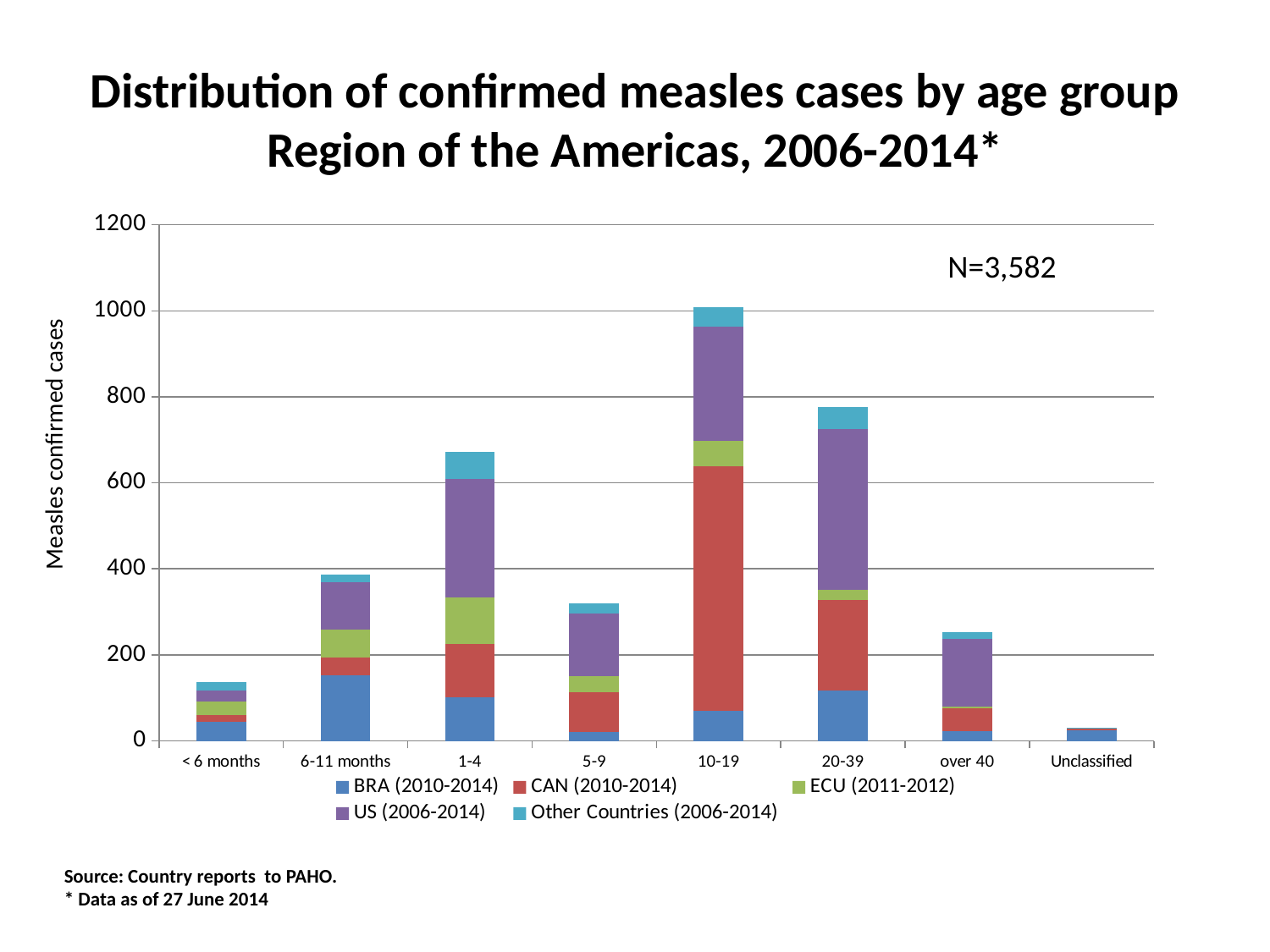
What kind of chart is shown on the slide? stacked bar chart Which series in the legend covers the years 2011-2012? ECU (2011-2012) Which has a larger total of confirmed cases, the 1-4 age group or the 5-9 age group? 1-4 Is the total for the < 6 months age group greater or less than 200? less Which age group has the highest total number of confirmed measles cases? 10-19 What is the total number of cases (N) stated on the chart? N=3,582 Is the total for the 20-39 age group greater or less than 800? less Is the total for the 10-19 age group greater or less than 800? greater Which age group has the lowest total number of confirmed measles cases? Unclassified How many age group categories are shown on the x axis? 8 How many series does the legend list? 5